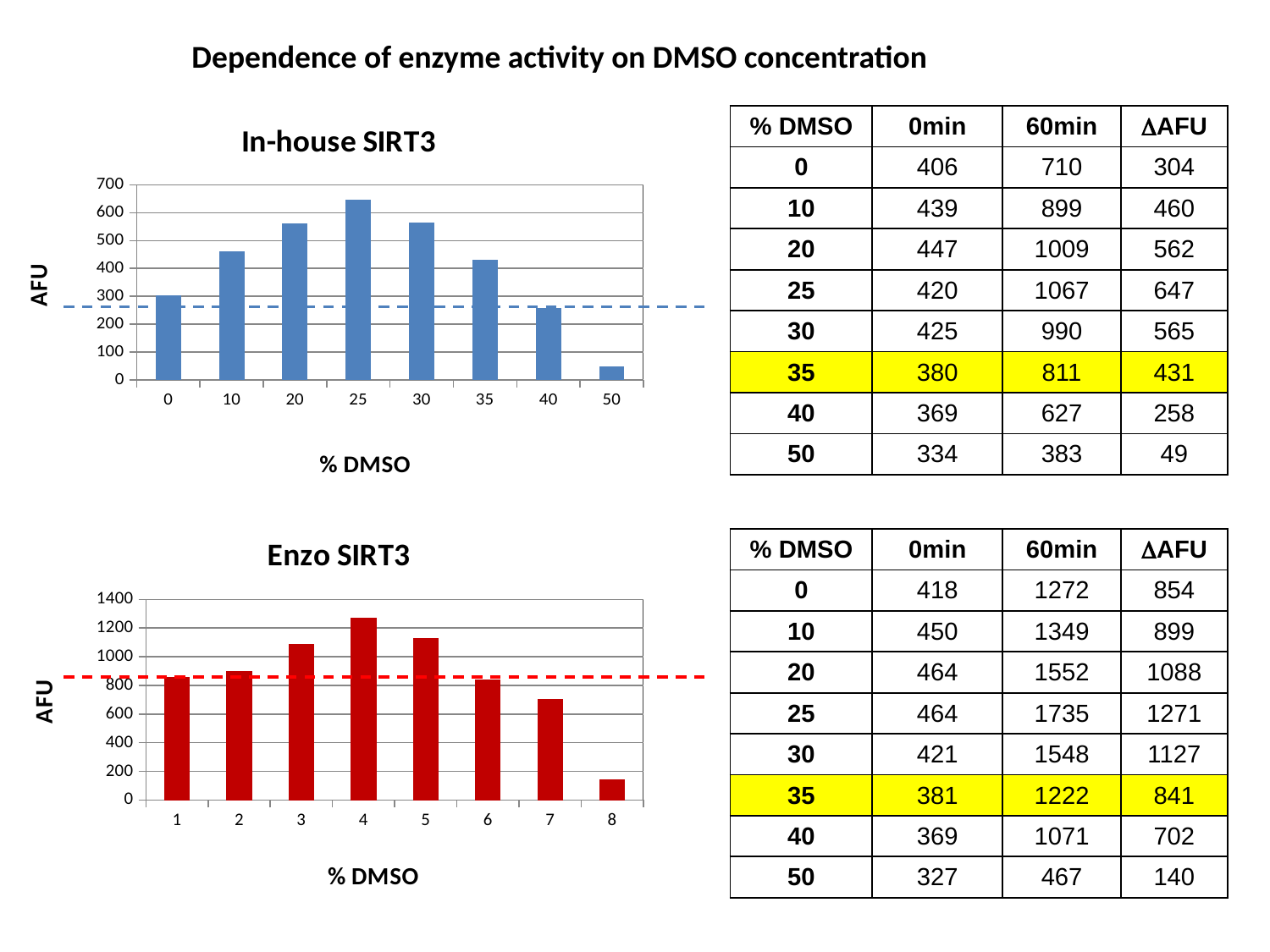
In the In-house SIRT3 chart, is the value for 10% DMSO greater or less than 400? greater In the In-house SIRT3 chart, which % DMSO category has the lowest AFU value? 50 In the In-house SIRT3 chart, is the value for 50% DMSO greater or less than 100? less In the Enzo SIRT3 chart, which category has the lowest AFU value? 8 What kind of chart is the Enzo SIRT3 chart? bar chart What is the y-axis label of the Enzo SIRT3 chart? AFU In the In-house SIRT3 chart, which is larger, the value for 10 or the value for 40? 10 In the Enzo SIRT3 chart, do the values rise or fall from category 4 to category 8? fall In the Enzo SIRT3 chart, which category has the highest AFU value? 4 In the Enzo SIRT3 chart, is the value for category 7 greater or less than 800? less How many bars are plotted in the In-house SIRT3 chart? 8 In the In-house SIRT3 chart, which % DMSO category has the highest AFU value? 25